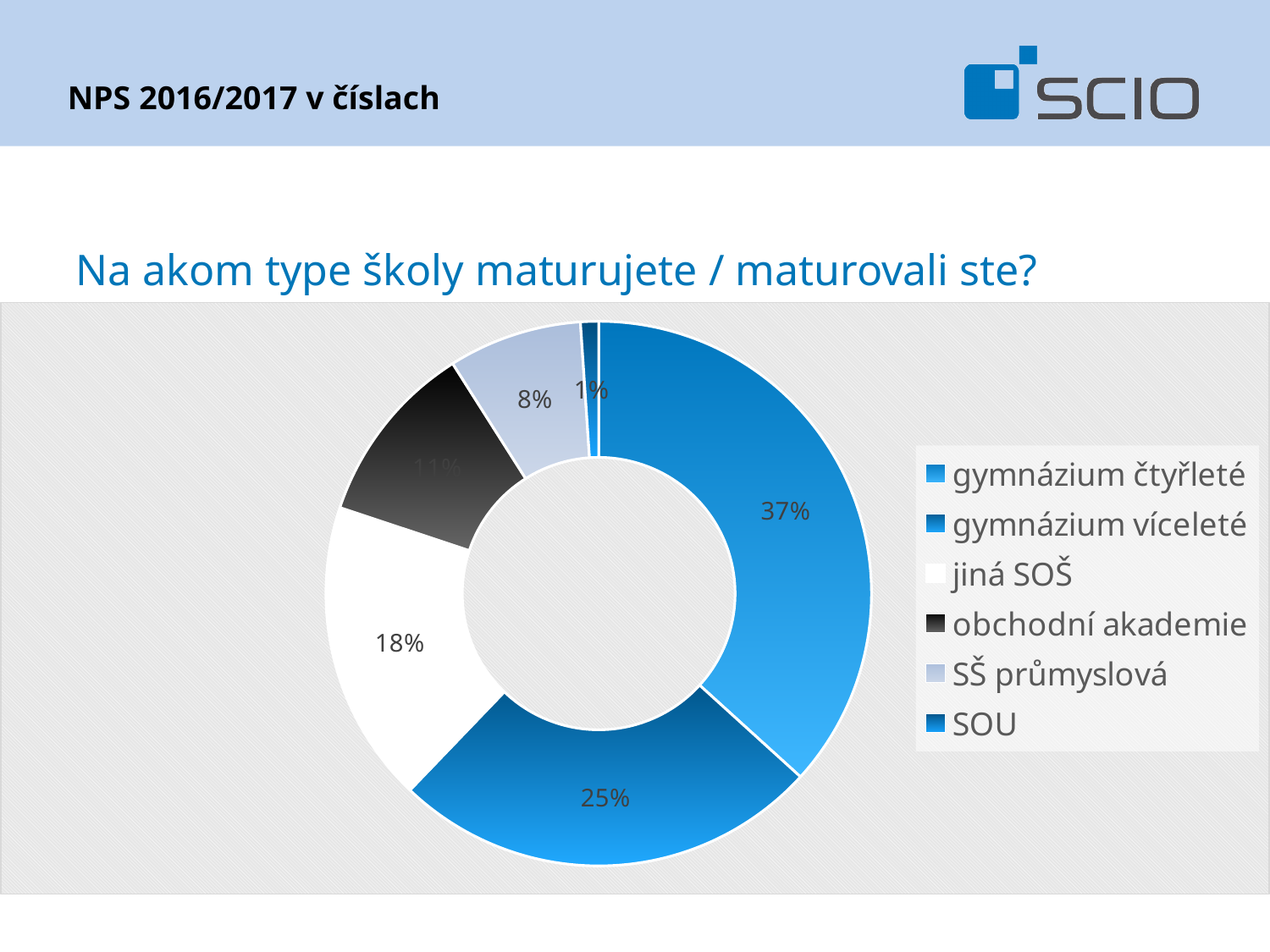
What share does gymnázium víceleté have in the chart? 25% What percentage is shown for SOU? 1% What is the value shown for jiná SOŠ? 18% What percentage is shown for SŠ průmyslová? 8% What is the title of the chart? Na akom type školy maturujete / maturovali ste? Which school type has the largest share in the chart? gymnázium čtyřleté What kind of chart is shown on the slide? doughnut chart What is the difference in percentage points between gymnázium čtyřleté and gymnázium víceleté? 12 What percentage of respondents chose gymnázium čtyřleté? 37% Which is larger, the share for jiná SOŠ or the share for SŠ průmyslová? jiná SOŠ How many categories does the legend list? 6 Which school type has the smallest share in the chart? SOU